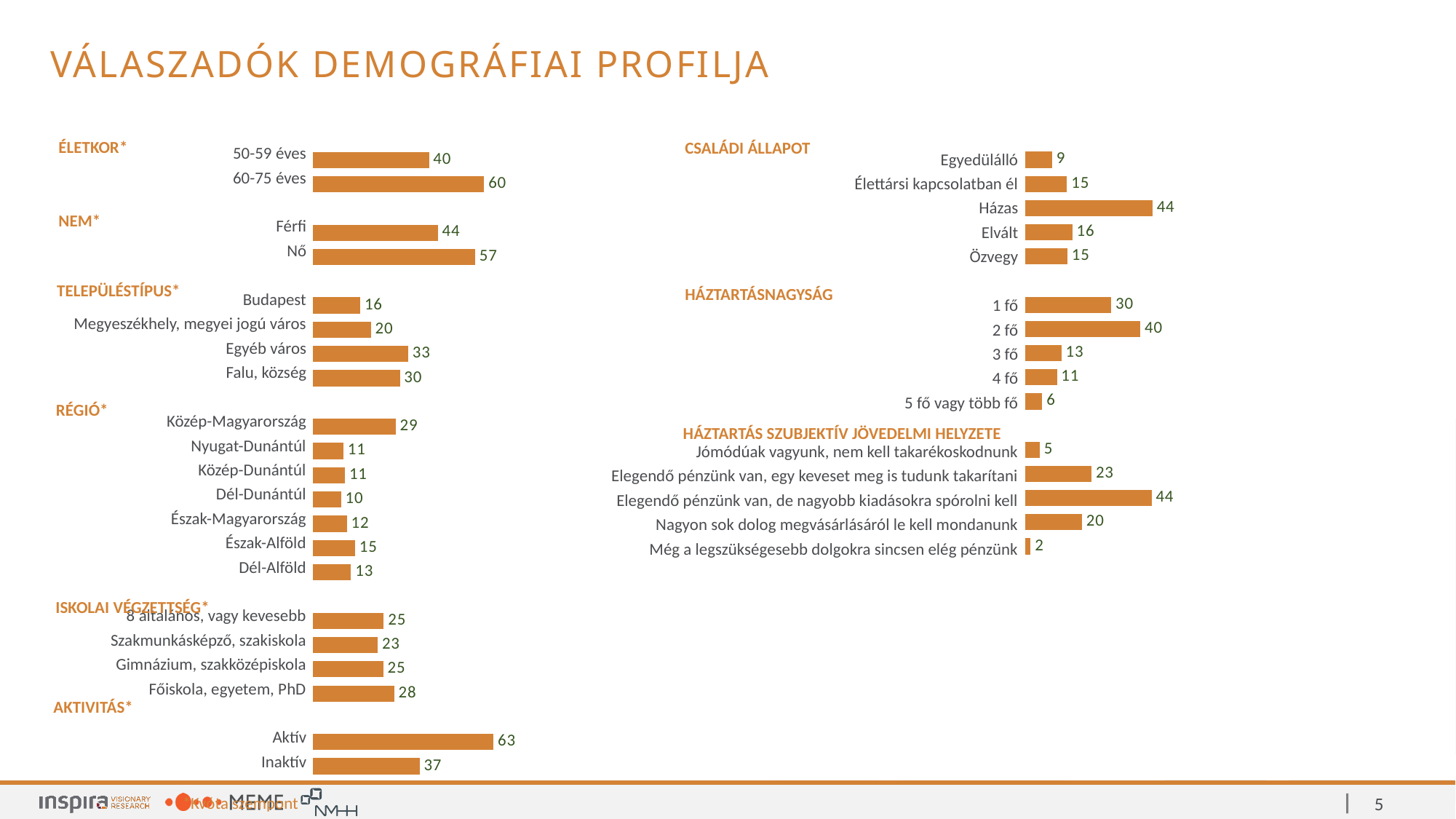
In the TELEPÜLÉSTÍPUS chart, which category has the highest value? Egyéb város In the ÉLETKOR chart, what is the value for 60-75 éves? 60 In the RÉGIÓ chart, which region has the lowest value? Dél-Dunántúl In the HÁZTARTÁSNAGYSÁG chart, what is the value for 2 fő? 40 In the RÉGIÓ chart, how many regions are shown? 7 In the NEM chart, what is the value for Nő? 57 In the HÁZTARTÁS SZUBJEKTÍV JÖVEDELMI HELYZETE chart, what is the value for 'Még a legszükségesebb dolgokra sincsen elég pénzünk'? 2 In the CSALÁDI ÁLLAPOT chart, which category has the highest value? Házas In the ISKOLAI VÉGZETTSÉG chart, what is the value for 'Főiskola, egyetem, PhD'? 28 What type of chart is used for the CSALÁDI ÁLLAPOT data? Bar chart In the AKTIVITÁS chart, what is the difference between Aktív and Inaktív? 26 In the HÁZTARTÁSNAGYSÁG chart, which is larger: 1 fő or 3 fő? 1 fő